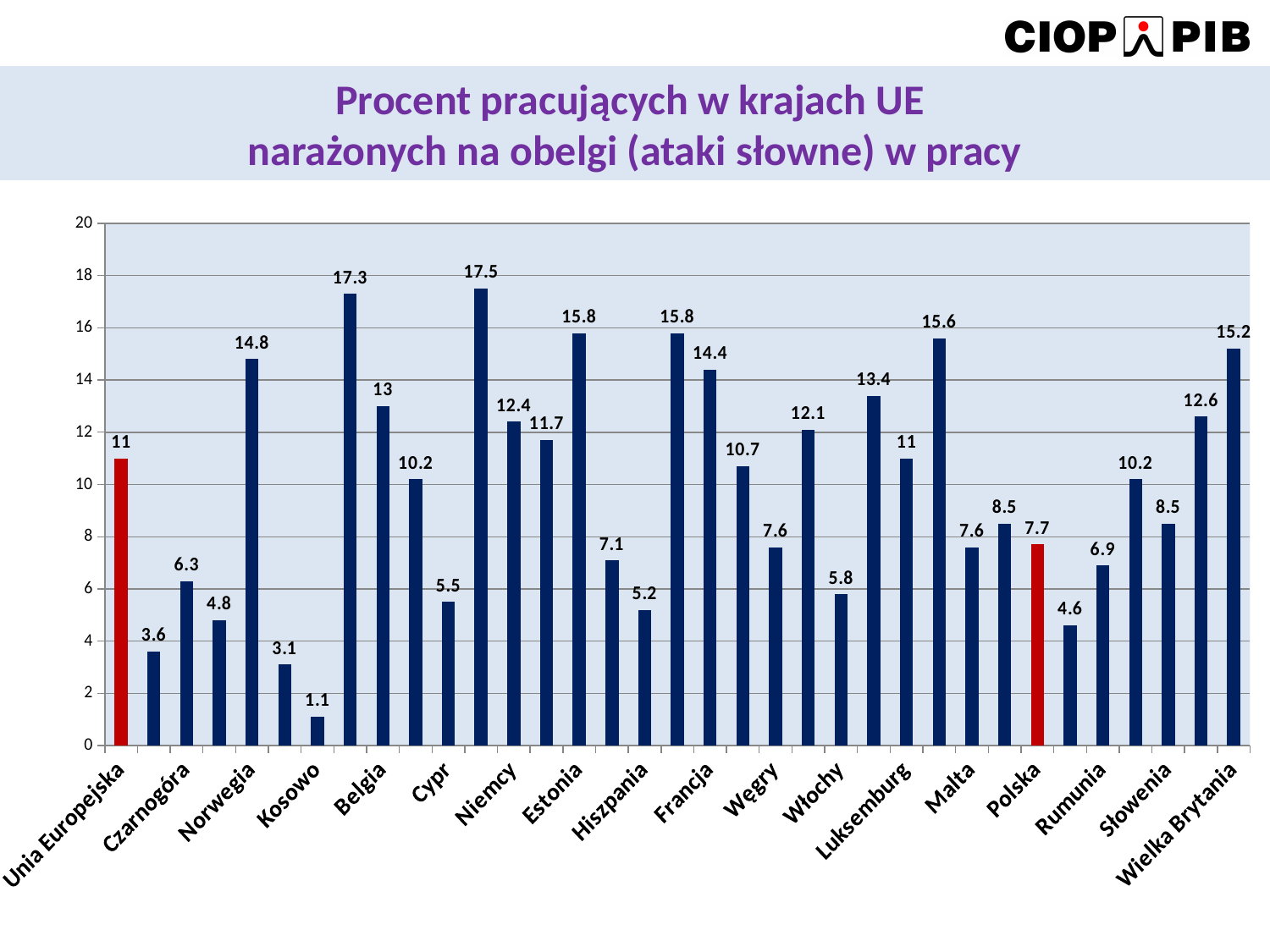
Which is larger, the value for Polska or the value for Unia Europejska? Unia Europejska What is the difference between the values for Unia Europejska and Polska? 3.3 Which labelled country has the lowest value? Kosowo Is the value for Estonia greater or less than 14? greater What kind of chart is shown on the slide? bar chart What is the value for Unia Europejska? 11 What colour is the bar for Polska? red What is the value for Wielka Brytania? 15.2 What is the highest value shown on the chart? 17.5 What is the value for Norwegia? 14.8 What is the value for Kosowo? 1.1 What is the value for Polska? 7.7